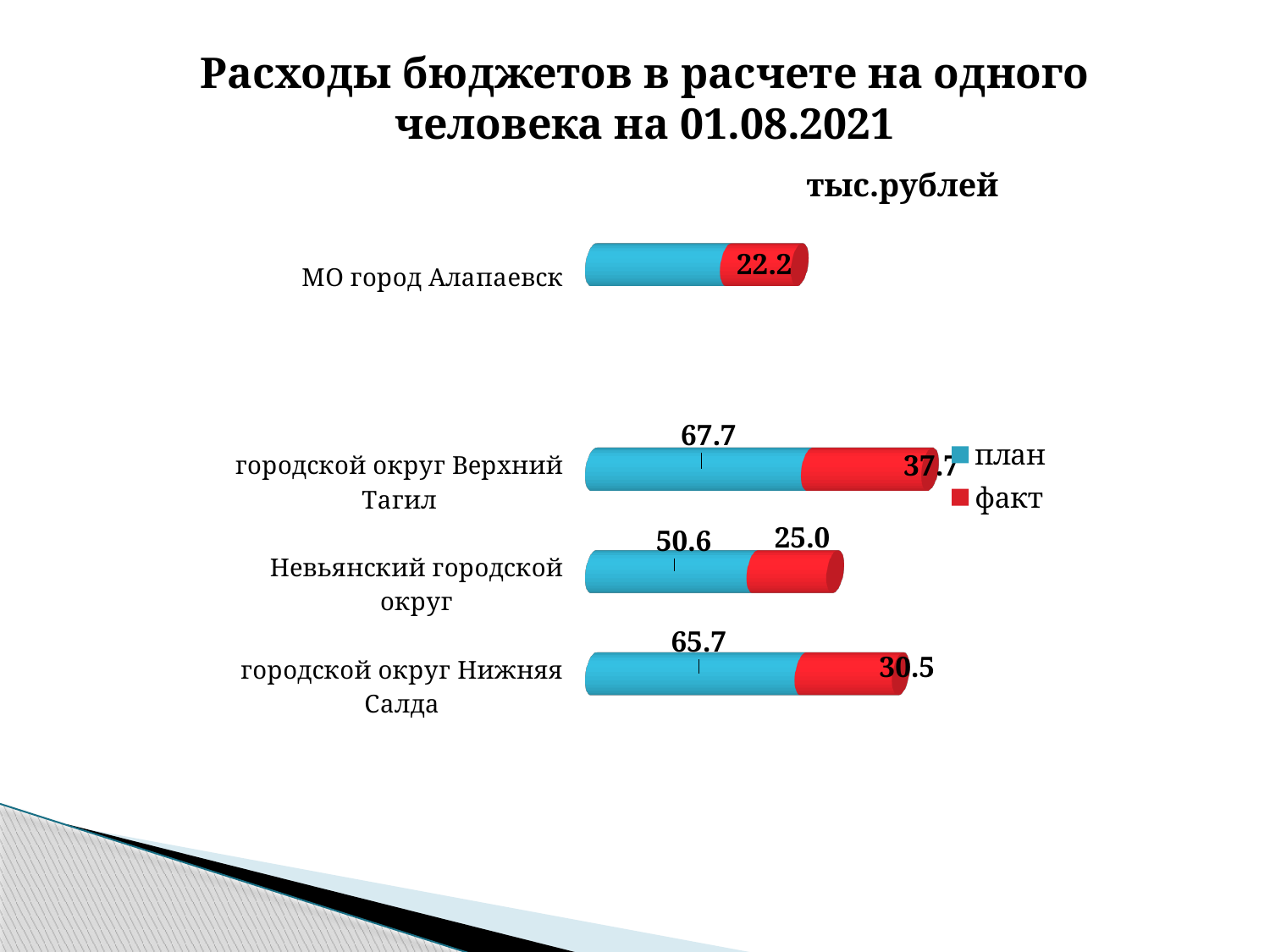
What is the difference between the план and факт values for городской округ Верхний Тагил? 30.0 Which has the larger факт value: городской округ Нижняя Салда or Невьянский городской округ? городской округ Нижняя Салда What is the difference between the план and факт values for Невьянский городской округ? 25.6 How many series does the legend list? 2 What is the план value for городской округ Нижняя Салда? 65.7 What is the план value for Невьянский городской округ? 50.6 What is the факт value for городской округ Верхний Тагил? 37.7 What kind of chart is shown on the slide? bar chart Which category has the lowest факт value? МО город Алапаевск Which category has the highest план value? городской округ Верхний Тагил How many categories are shown in the chart? 4 What is the факт value for МО город Алапаевск? 22.2